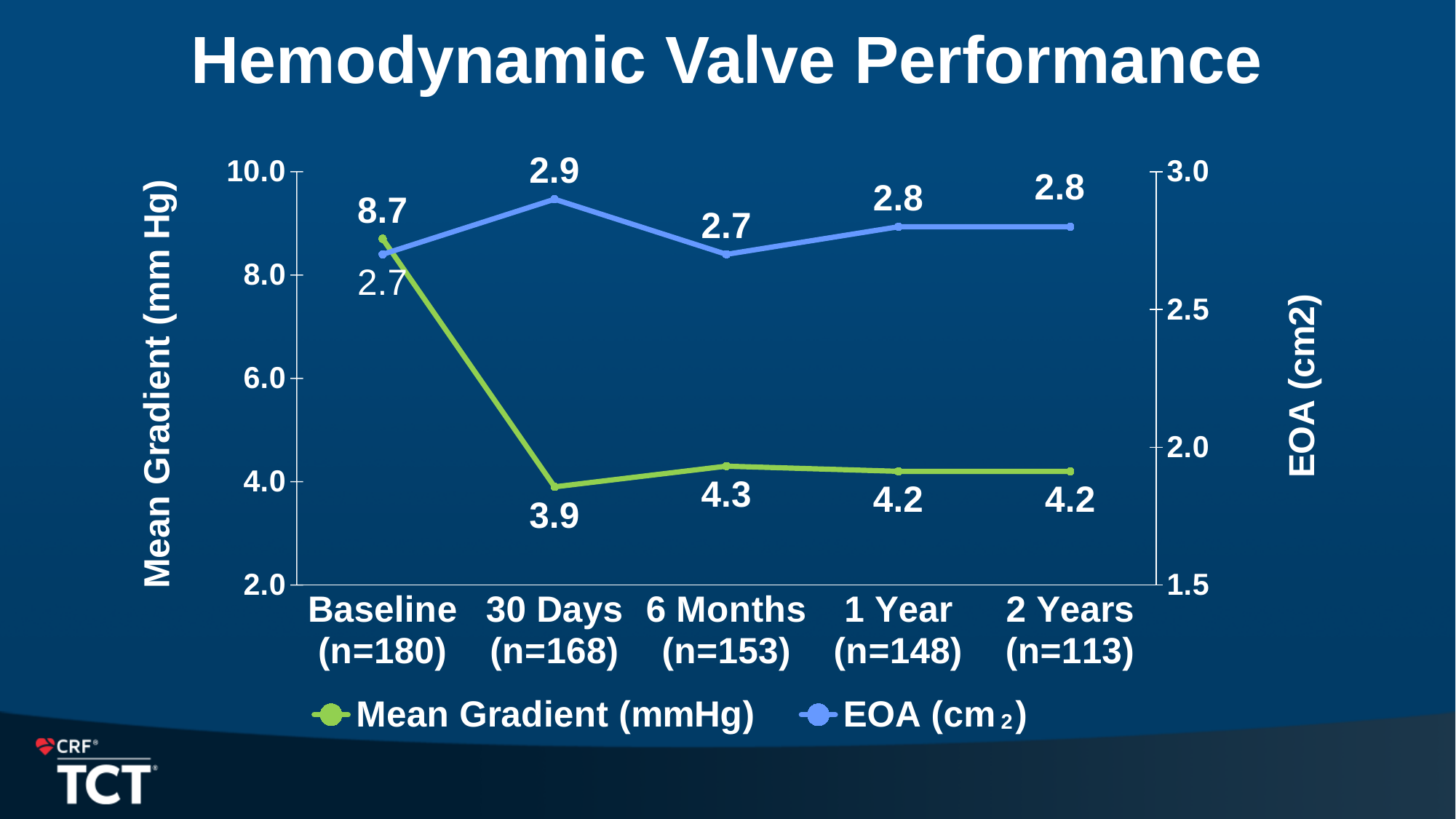
At which time point is the Mean Gradient lowest? 30 Days At which time point is the Mean Gradient highest? Baseline What type of chart is shown on the slide? Line chart How many series does the legend list? 2 How many time points are plotted on the x axis? 5 At which time point is the EOA highest? 30 Days What is the Mean Gradient at 6 Months? 4.3 What is the Mean Gradient at Baseline? 8.7 What is the difference in Mean Gradient between Baseline and 30 Days? 4.8 What is the EOA value at 2 Years? 2.8 Is the Mean Gradient higher at Baseline or at 1 Year? Baseline What is the EOA value at 30 Days? 2.9